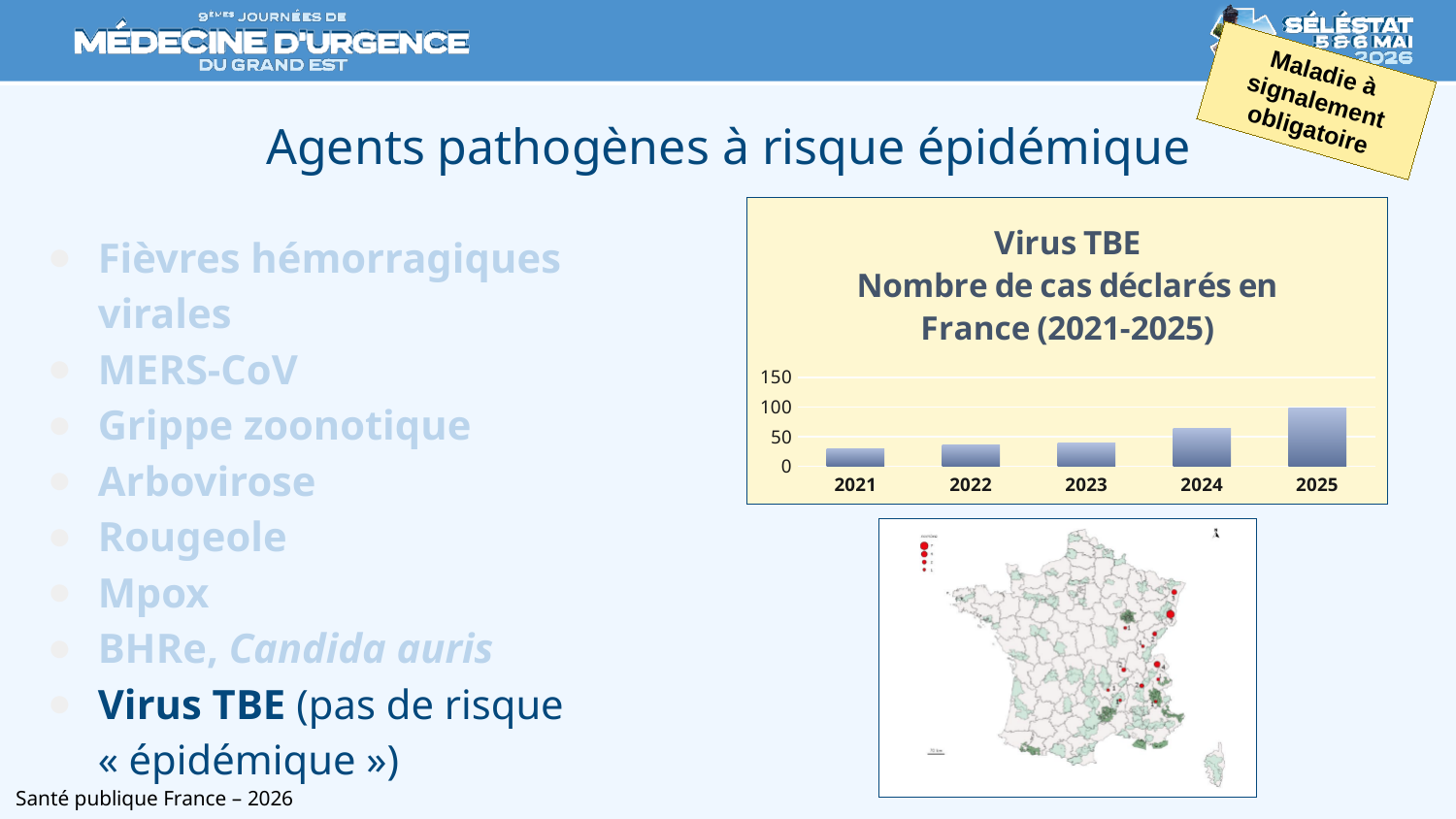
What kind of chart is shown in the 'Virus TBE' chart? bar chart In the 'Virus TBE' chart, is the value for 2023 greater or less than 50? less In the 'Virus TBE' chart, is the value for 2024 greater or less than 50? greater In the 'Virus TBE' chart, which year has the highest number of declared cases? 2025 How many years are shown on the x axis of the 'Virus TBE' chart? 5 What is the title of the bar chart on the slide? Virus TBE Nombre de cas déclarés en France (2021-2025) In the 'Virus TBE' chart, is the value for 2021 greater or less than 50? less In the 'Virus TBE' chart, do the number of cases rise or fall from 2021 to 2025? rise What is the highest value shown on the y axis of the 'Virus TBE' chart? 150 In the 'Virus TBE' chart, which year has the lowest number of declared cases? 2021 In the 'Virus TBE' chart, which year has more declared cases, 2022 or 2024? 2024